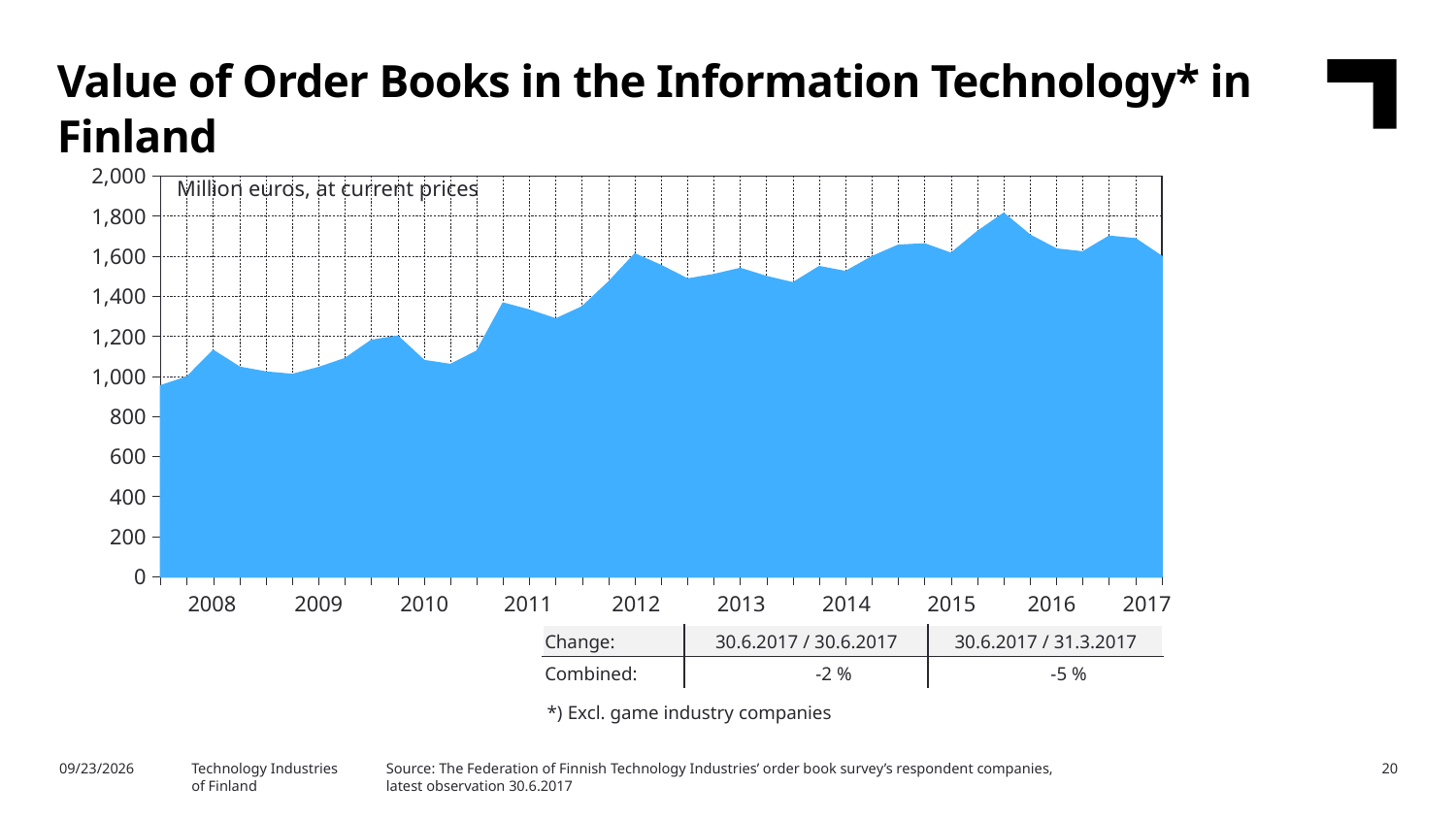
Is the peak value of the order books, reached between 2015 and 2016, greater or less than 1,600? greater Is the value at the start of 2011 greater or less than 1,200? greater How many year labels are shown on the x axis? 10 Overall, do the values rise or fall from 2008 to 2017? rise What is the combined change for 30.6.2017 / 31.3.2017 shown in the table below the chart? -5 % Is the value at the start of 2008 greater or less than 1,200? less What is the highest value shown on the y axis? 2,000 In what unit are the values on the chart expressed, according to the label inside the plot area? Million euros, at current prices What is the title of the chart? Value of Order Books in the Information Technology* in Finland What kind of chart is shown on the slide? area chart What is the combined change for 30.6.2017 / 30.6.2017 shown in the table below the chart? -2 %